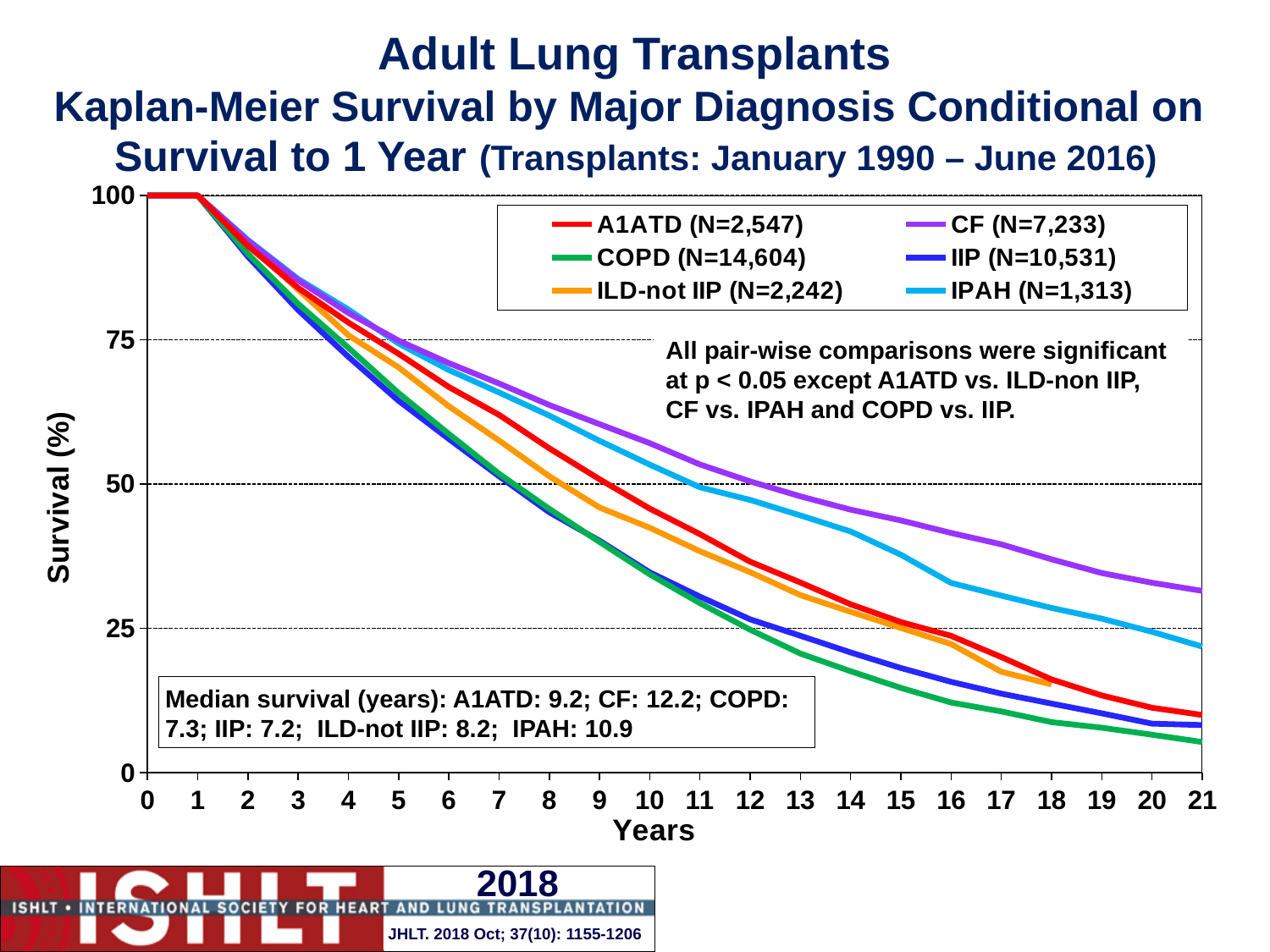
What kind of chart is shown on the slide? line chart What is the median survival in years for the CF group, as stated on the slide? 12.2 Is the survival for COPD at 10 years greater or less than 50%? less Which diagnosis group has the highest survival at 21 years? CF How many diagnosis groups does the legend list? 6 What is the difference in median survival (years) between CF and COPD, using the values stated on the slide? 4.9 Do the survival curves rise or fall as years increase? fall According to the legend, how many patients (N) are in the COPD group? 14,604 Which diagnosis group has the lowest survival at 21 years? COPD What is the median survival in years for the IIP group, as stated on the slide? 7.2 At 15 years, which group has higher survival, IPAH or IIP? IPAH Is the survival for CF at 10 years greater or less than 50%? greater